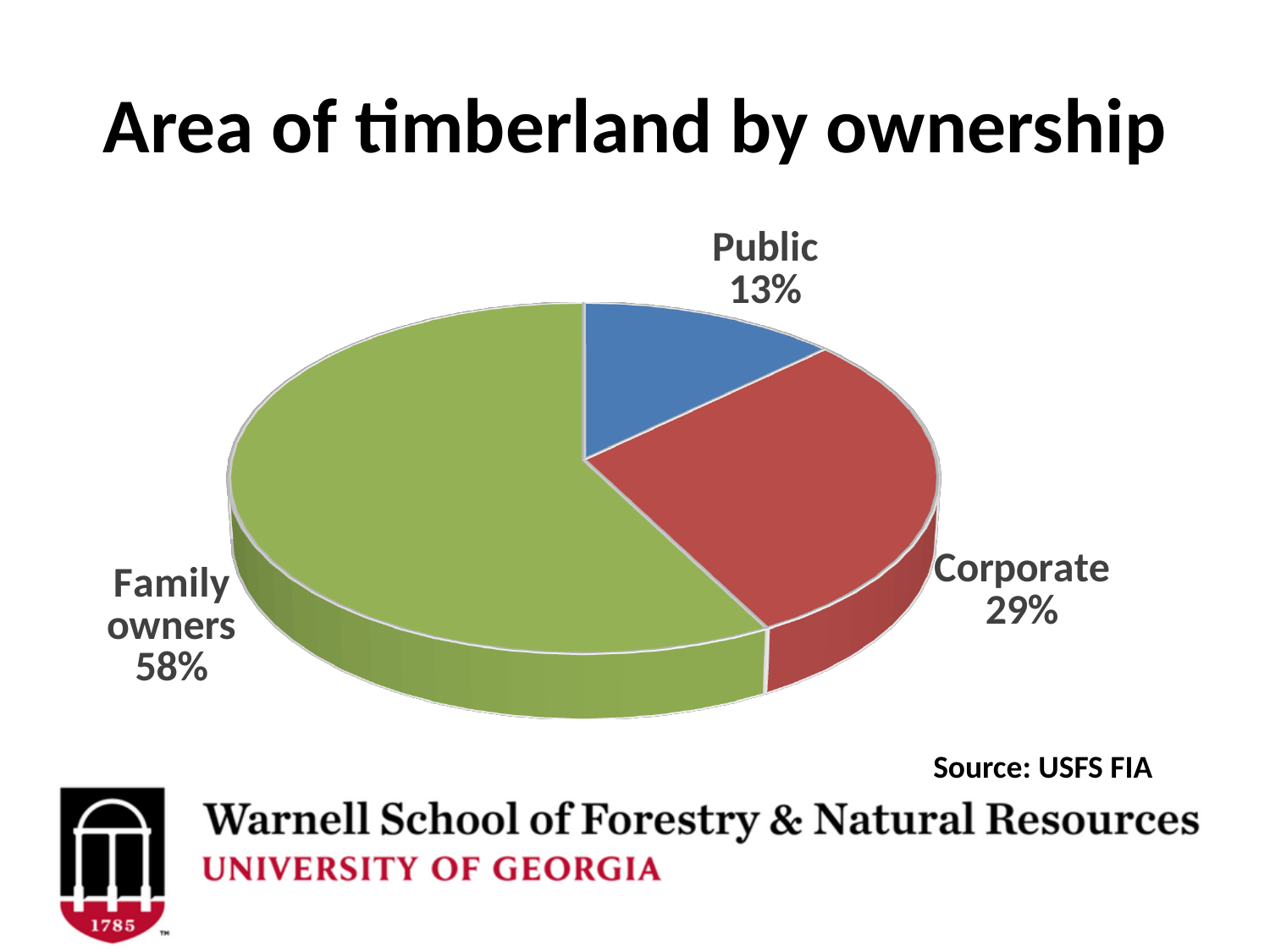
Which ownership category has the largest share of timberland area? Family owners What colour is the slice for family owners? Green What share of timberland area is corporate-owned? 29% What is the title of the chart? Area of timberland by ownership Which is larger, the corporate share or the public share? Corporate How many ownership categories are shown in the pie chart? 3 How many percentage points larger is the family owners share than the corporate share? 29 What kind of chart is shown on the slide? Pie chart Which ownership category has the smallest share of timberland area? Public How many percentage points larger is the corporate share than the public share? 16 What share of timberland area is public? 13% What share of timberland area is owned by family owners? 58%